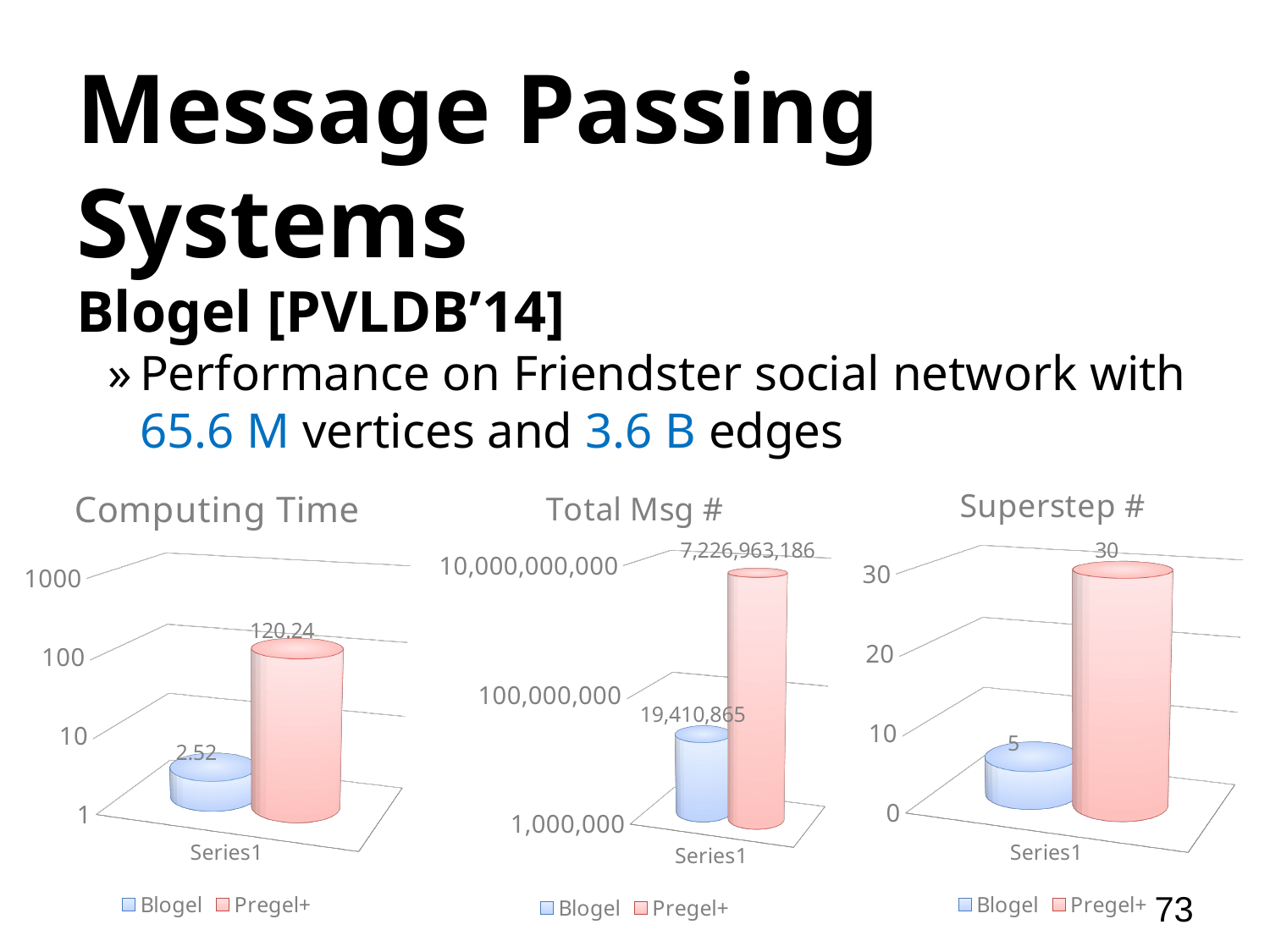
What kind of chart is the Total Msg # chart? bar chart In the Total Msg # chart, what is the value for Blogel? 19,410,865 In the Computing Time chart, what is the value for Blogel? 2.52 In the Total Msg # chart, which series has the lowest value? Blogel In the Superstep # chart, what is the value for Pregel+? 30 In the Total Msg # chart, what is the value for Pregel+? 7,226,963,186 In the Computing Time chart, what is the value for Pregel+? 120.24 How many charts are shown on the slide? 3 In the Superstep # chart, what is the difference between the Pregel+ and Blogel values? 25 In the Computing Time chart, is the value for Pregel+ greater or less than 100? greater In the Computing Time chart, which series has the higher value, Blogel or Pregel+? Pregel+ How many series does the legend of the Superstep # chart list? 2